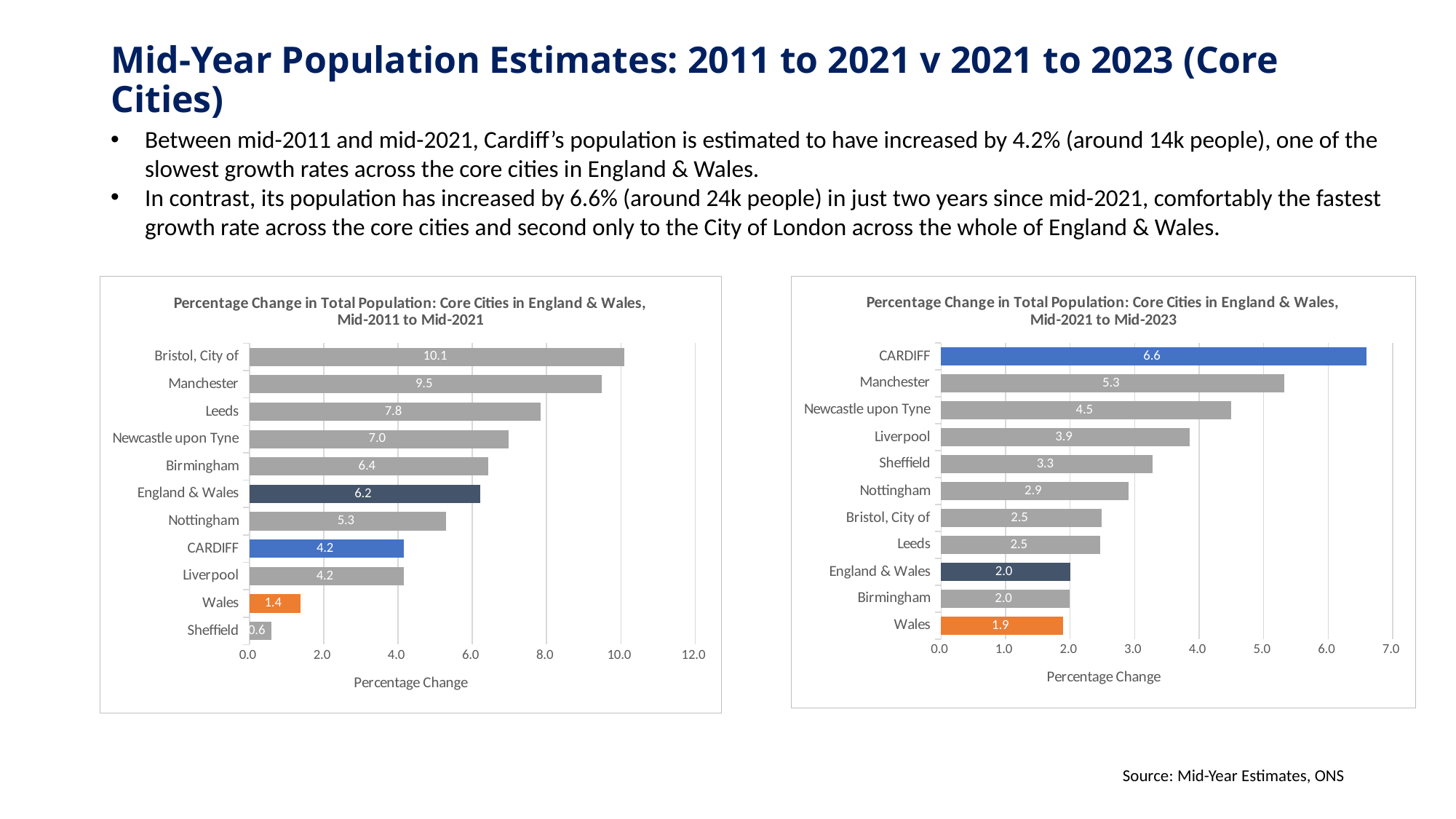
In the Mid-2011 to Mid-2021 chart, what is the percentage change for Wales? 1.4 How many categories are shown in the Mid-2011 to Mid-2021 chart? 11 In the Mid-2021 to Mid-2023 chart, what is the x-axis title? Percentage Change In the Mid-2011 to Mid-2021 chart, what is the difference between the values for Manchester and Leeds? 1.7 In the Mid-2021 to Mid-2023 chart, what is the percentage change for CARDIFF? 6.6 In the Mid-2011 to Mid-2021 chart, what is the percentage change for Bristol, City of? 10.1 In the Mid-2011 to Mid-2021 chart, which category has the lowest percentage change? Sheffield In the Mid-2021 to Mid-2023 chart, is the value for Newcastle upon Tyne greater or less than 4.0? greater In the Mid-2011 to Mid-2021 chart, which is larger, the value for Birmingham or the value for Nottingham? Birmingham In the Mid-2021 to Mid-2023 chart, what is the difference between the values for CARDIFF and Manchester? 1.3 What kind of chart is the Mid-2021 to Mid-2023 chart? bar chart In the Mid-2021 to Mid-2023 chart, which category has the highest percentage change? CARDIFF